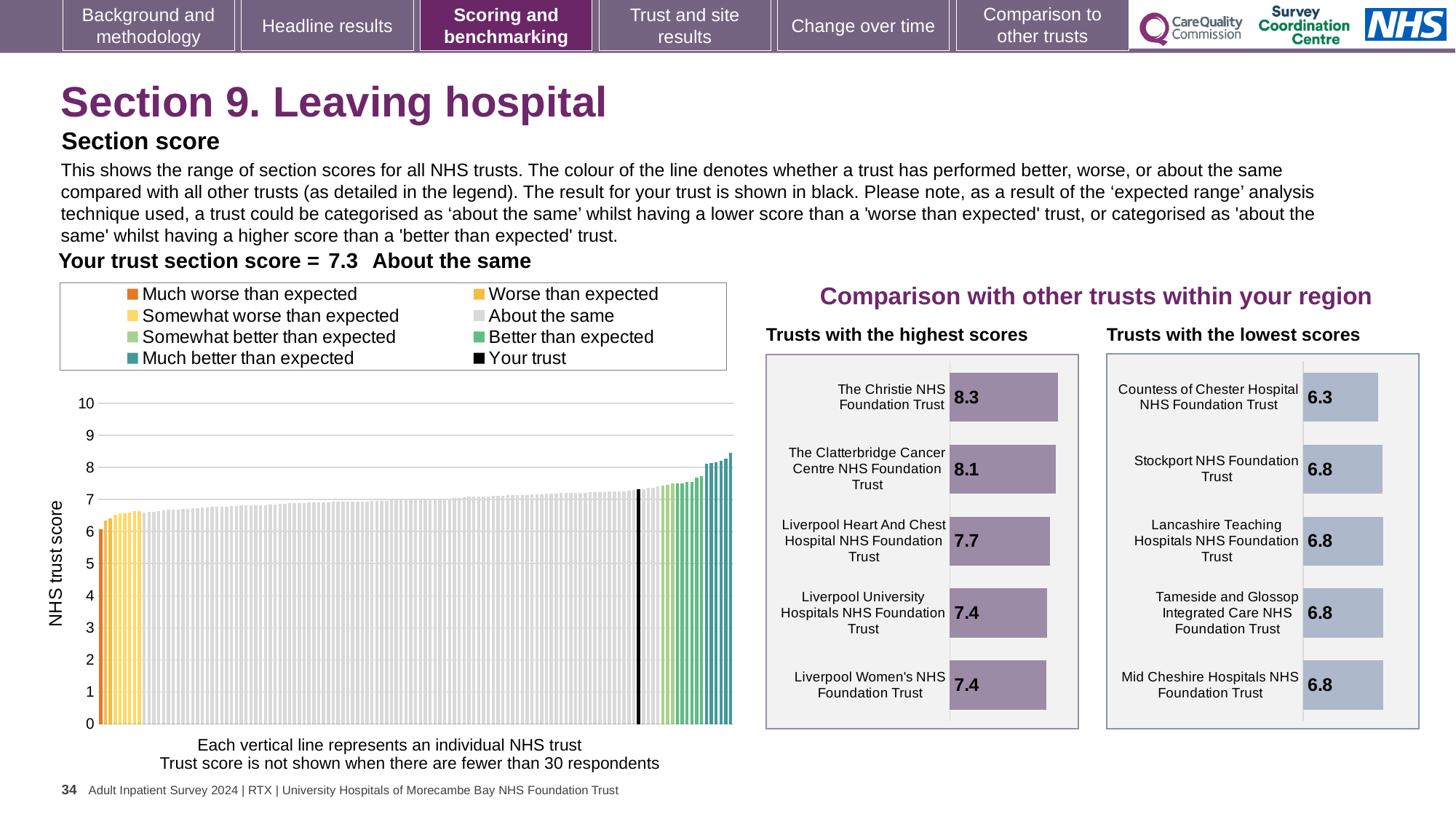
In the 'Trusts with the lowest scores' chart, what is the difference between the scores of Stockport NHS Foundation Trust and Countess of Chester Hospital NHS Foundation Trust? 0.5 In the 'Trusts with the highest scores' chart, what is the score for The Christie NHS Foundation Trust? 8.3 In the main chart on the left showing all NHS trusts, what is the section score for your trust (the black line)? 7.3 In the 'Trusts with the lowest scores' chart, what is the score for Countess of Chester Hospital NHS Foundation Trust? 6.3 In the 'Trusts with the highest scores' chart, which has the larger score: The Clatterbridge Cancer Centre NHS Foundation Trust or Liverpool Women's NHS Foundation Trust? The Clatterbridge Cancer Centre NHS Foundation Trust How many entries does the legend of the main chart on the left list? 8 In the 'Trusts with the lowest scores' chart, which trust has the lowest score? Countess of Chester Hospital NHS Foundation Trust How many trusts are shown in the 'Trusts with the lowest scores' chart? 5 In the 'Trusts with the highest scores' chart, which trust has the highest score? The Christie NHS Foundation Trust In the 'Trusts with the highest scores' chart, what is the score for Liverpool Heart And Chest Hospital NHS Foundation Trust? 7.7 In the main chart on the left showing all NHS trusts, is the value of the tallest bar greater or less than 8? greater In the 'Trusts with the highest scores' chart, what is the difference between the scores of The Christie NHS Foundation Trust and The Clatterbridge Cancer Centre NHS Foundation Trust? 0.2